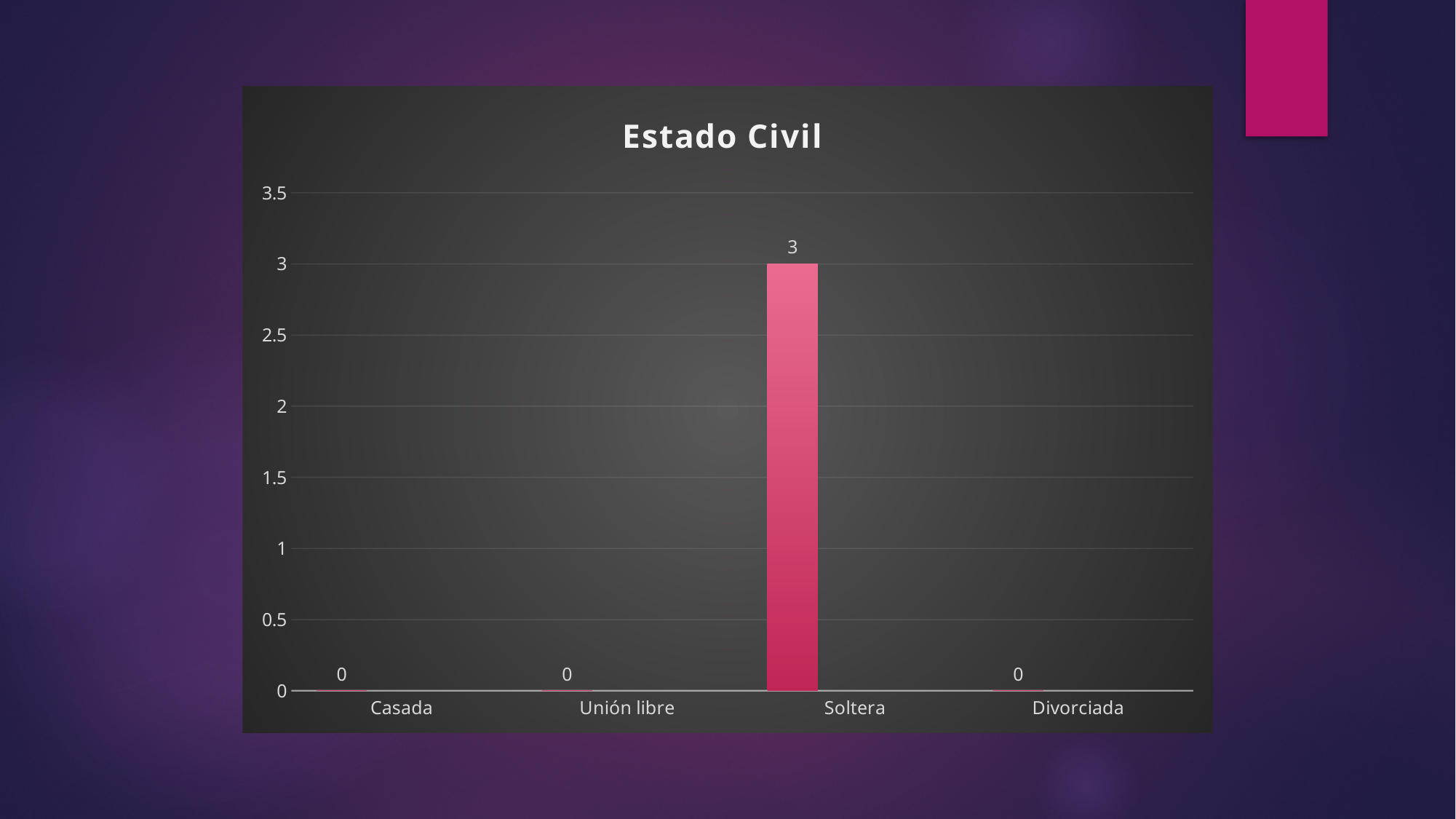
What is the title of the chart? Estado Civil What is the highest value shown on the y axis? 3.5 What kind of chart is shown? bar chart What is the value for Casada? 0 What is the value for Soltera? 3 Which category has the highest value? Soltera What is the value for Unión libre? 0 How many categories are shown on the x axis? 4 What is the value for Divorciada? 0 Which is larger, the value for Soltera or the value for Divorciada? Soltera What is the difference between the values for Soltera and Casada? 3 Is the value for Soltera greater or less than 2? greater